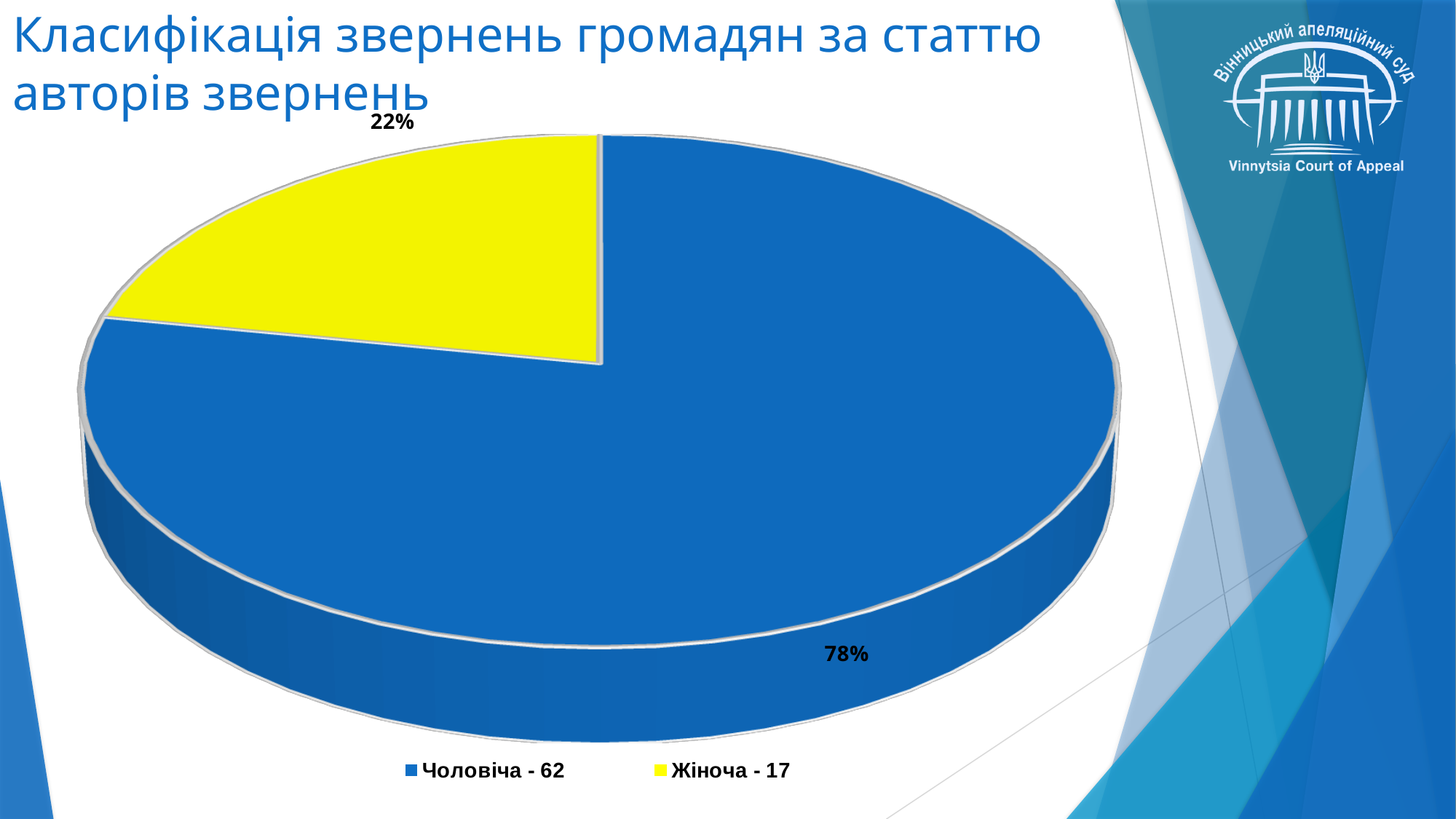
What is the difference between the Чоловіча count and the Жіноча count? 45 What colour is the Жіноча slice? yellow What kind of chart is shown on the slide? pie chart Which category has the smallest slice? Жіноча What count is given for Чоловіча in the legend? 62 What percentage share does the Чоловіча slice have? 78% What percentage share does the Жіноча slice have? 22% What is the total of the counts shown in the legend? 79 What count is given for Жіноча in the legend? 17 Which is larger, the Чоловіча slice or the Жіноча slice? Чоловіча Which category has the largest slice? Чоловіча How many slices does the pie chart have? 2